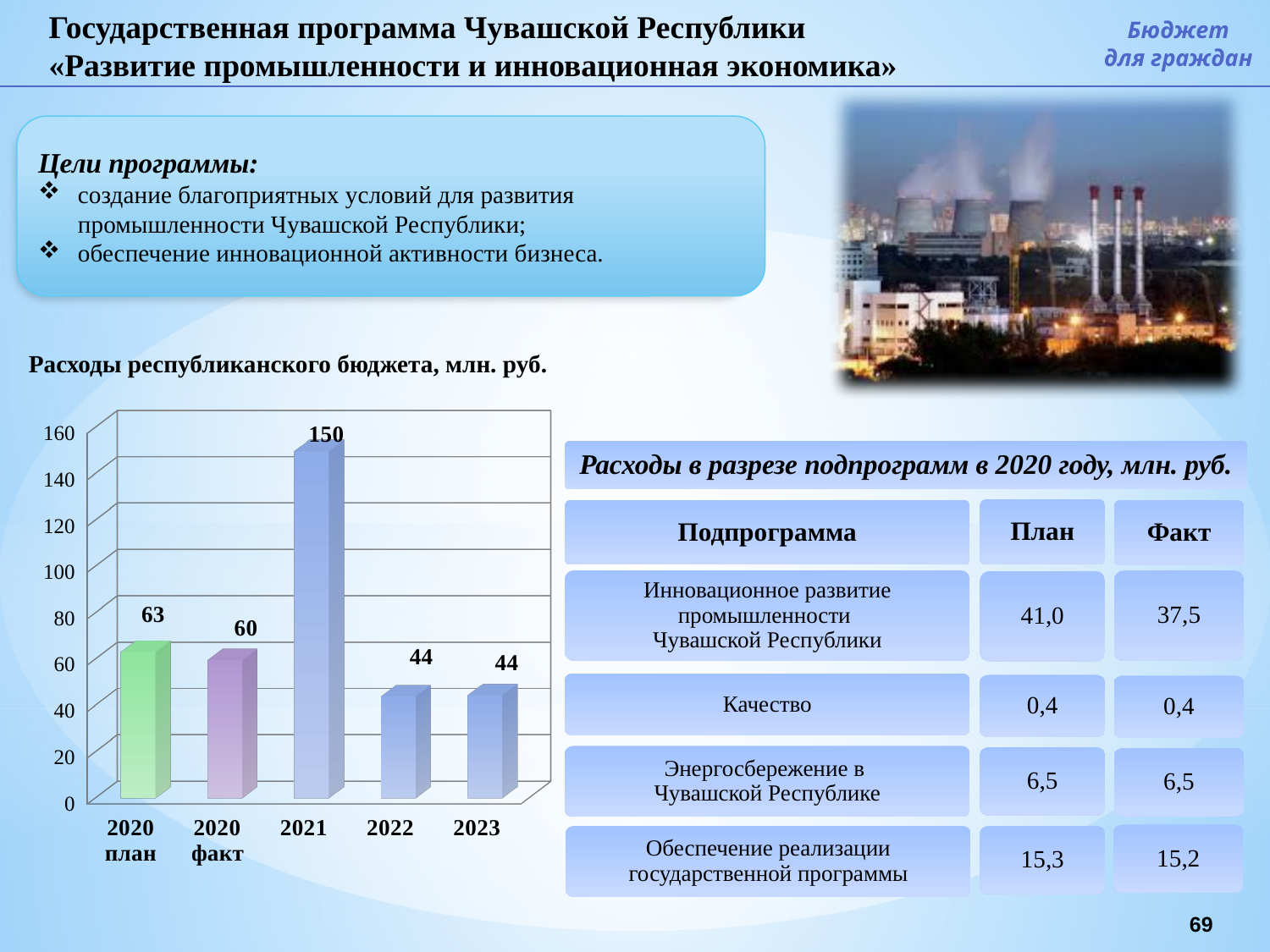
What is the value for "2020 план" in the chart? 63 What is the value for 2021 in the chart "Расходы республиканского бюджета, млн. руб."? 150 What kind of chart is shown on the slide? bar chart What is the difference between the values for 2021 and 2022 in the chart? 106 How many bars are shown in the chart? 5 What is the difference between "2020 план" and "2020 факт" in the chart? 3 Which category has the highest value in the chart? 2021 What is the value for "2020 факт" in the chart? 60 What is the value for 2023 in the chart? 44 Which is larger in the chart, the value for "2020 план" or the value for 2022? 2020 план Is the value for 2021 in the chart greater or less than 140? greater What is the title of the chart on the slide? Расходы республиканского бюджета, млн. руб.